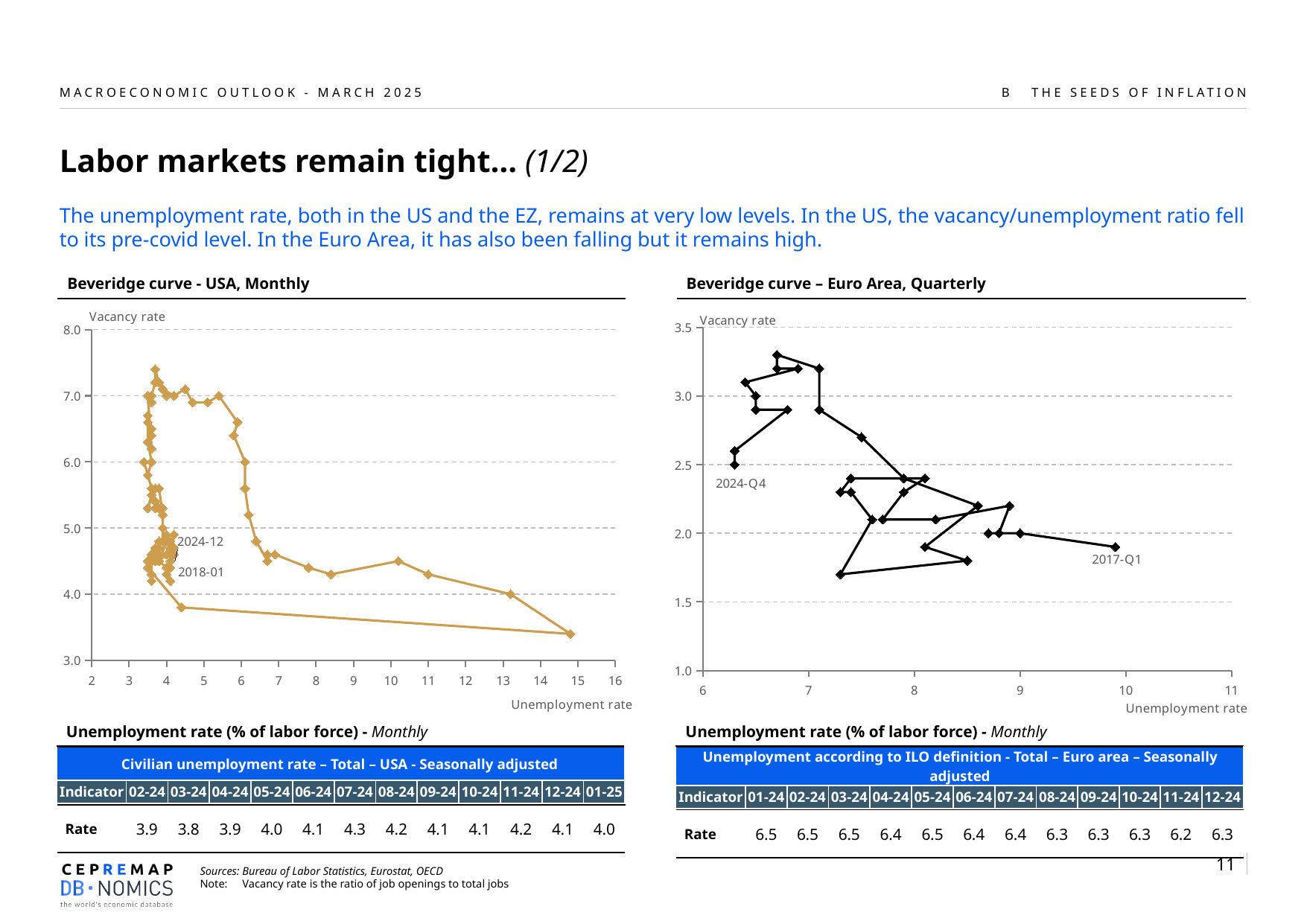
In the Beveridge curve – Euro Area, Quarterly chart, is the unemployment rate at the point labelled 2024-Q4 greater or less than 7? less In the Beveridge curve – Euro Area, Quarterly chart, which labelled point has the higher unemployment rate, 2017-Q1 or 2024-Q4? 2017-Q1 In the Beveridge curve - USA, Monthly chart, is the vacancy rate at the point labelled 2024-12 greater or less than 6.0? less In the Beveridge curve - USA, Monthly chart, is the unemployment rate at the rightmost point greater or less than 14? greater What is the title of the chart on the right side of the slide? Beveridge curve – Euro Area, Quarterly In the Beveridge curve - USA, Monthly chart, which labelled point has the higher vacancy rate, 2024-12 or 2018-01? 2024-12 In the Beveridge curve - USA, Monthly chart, what variable is plotted on the horizontal axis? Unemployment rate What is the highest value shown on the vertical axis of the Beveridge curve – Euro Area, Quarterly chart? 3.5 What is the title of the chart on the left side of the slide? Beveridge curve - USA, Monthly